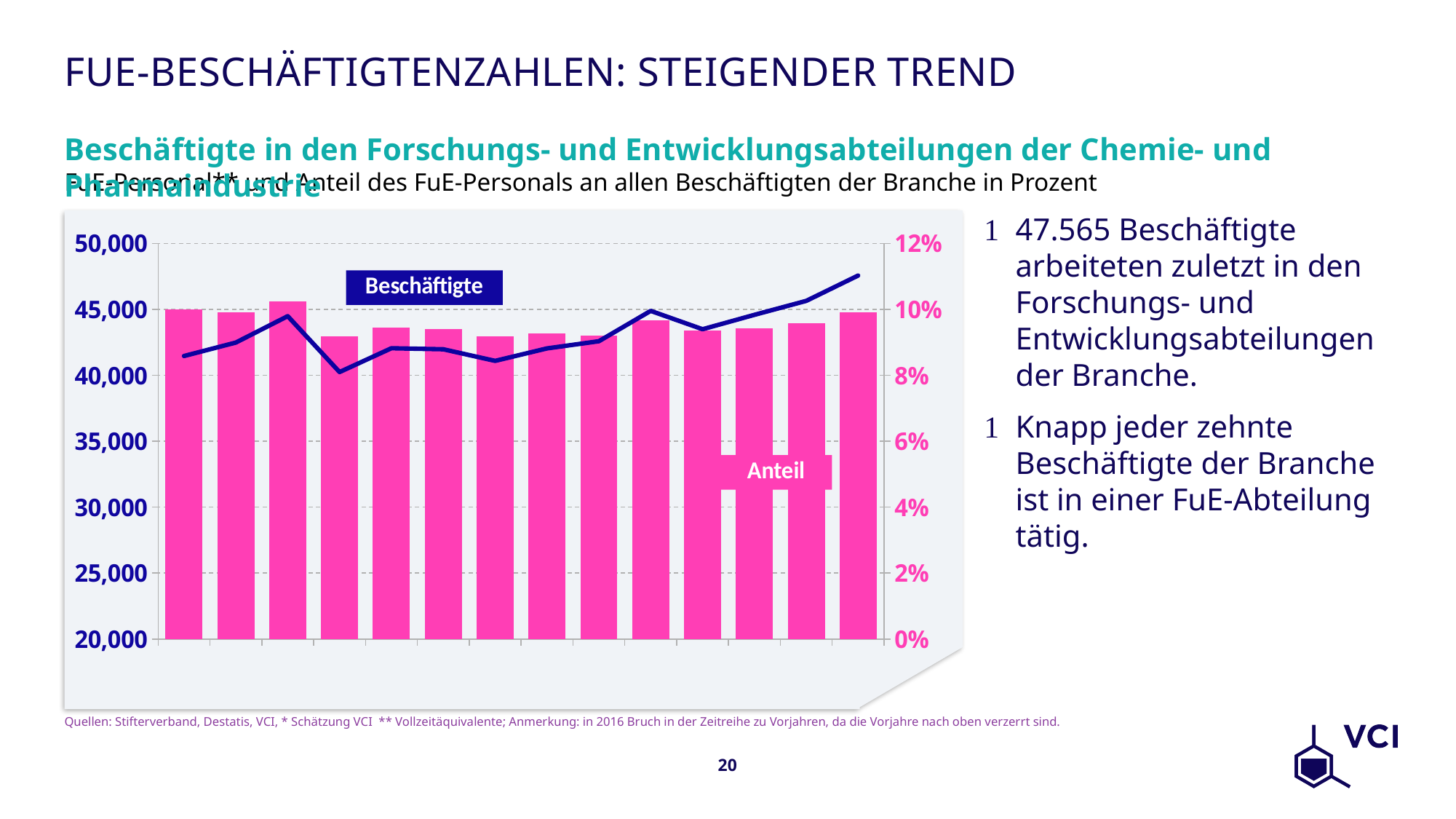
Is the value of the first (leftmost) point of the Beschäftigte line greater or less than 40,000? greater How many data series does the chart show? 2 Is the value of the lowest Anteil bar greater or less than 8%? greater What kind of chart is shown on the slide? A combined bar and line chart Is the value of the rightmost Anteil bar greater or less than 8%? greater Does the Beschäftigte line overall rise or fall from left to right? Rise Which series is drawn as bars in the chart? Anteil Which is larger: the last point of the Beschäftigte line or the first point of the Beschäftigte line? The last point How many bars are plotted in the chart? 14 Which series is drawn as a line in the chart? Beschäftigte